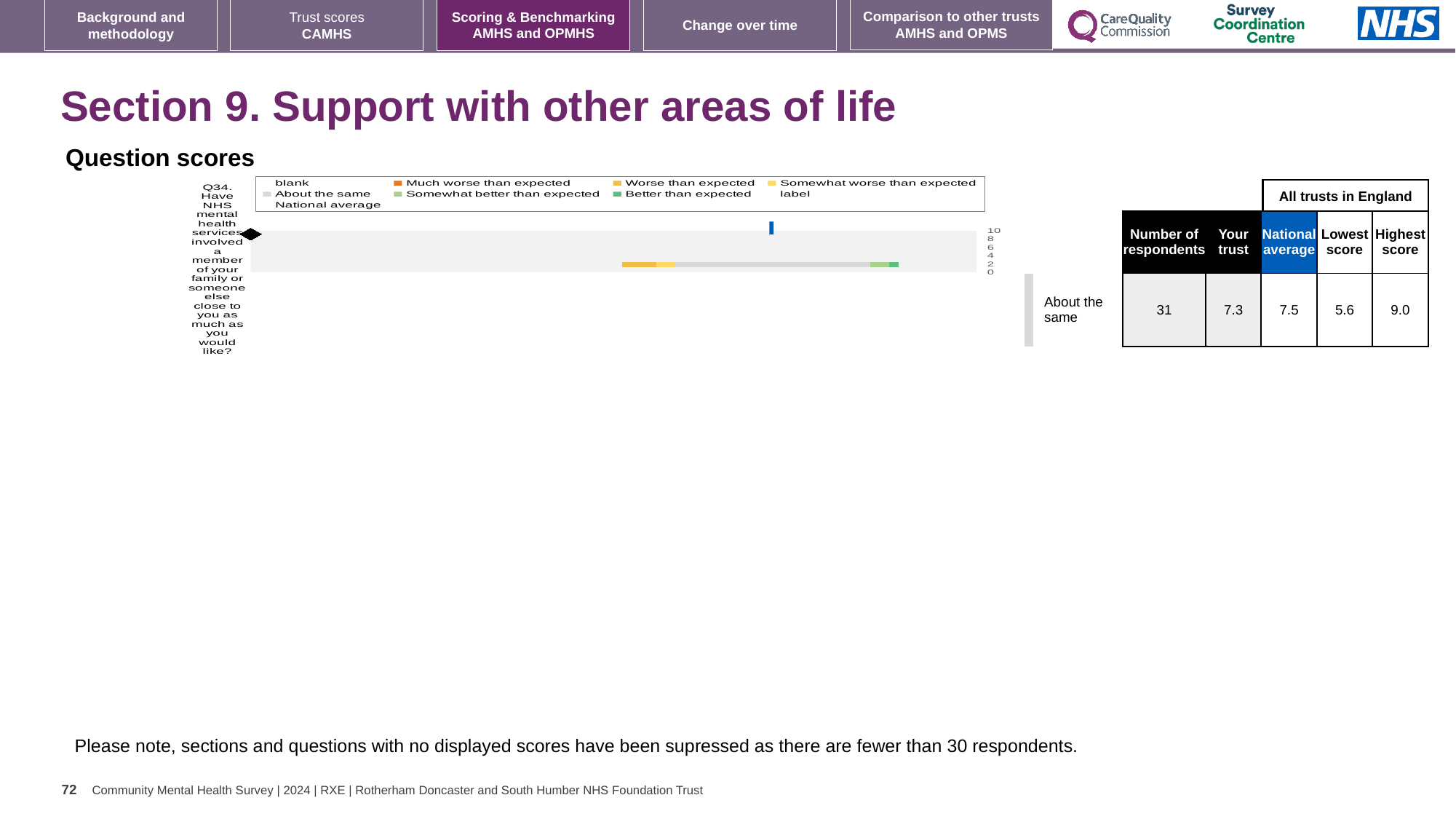
For Q34, which is larger: the 'Your trust' score or the national average? National average What is the difference between the highest score and the lowest score for Q34? 3.4 What is the highest value shown on the axis of the Question scores chart? 10 What kind of chart is shown under 'Question scores'? bar chart What is the national average score for Q34? 7.5 How many questions are plotted in the Question scores chart? 1 What is the highest score among all trusts in England for Q34? 9.0 Is the national average marker for Q34 greater or less than 6 on the chart axis? greater Which question number is plotted in the Question scores chart? Q34 What is the number of respondents for Q34? 31 What is the 'Your trust' score for Q34? 7.3 What is the lowest score among all trusts in England for Q34? 5.6